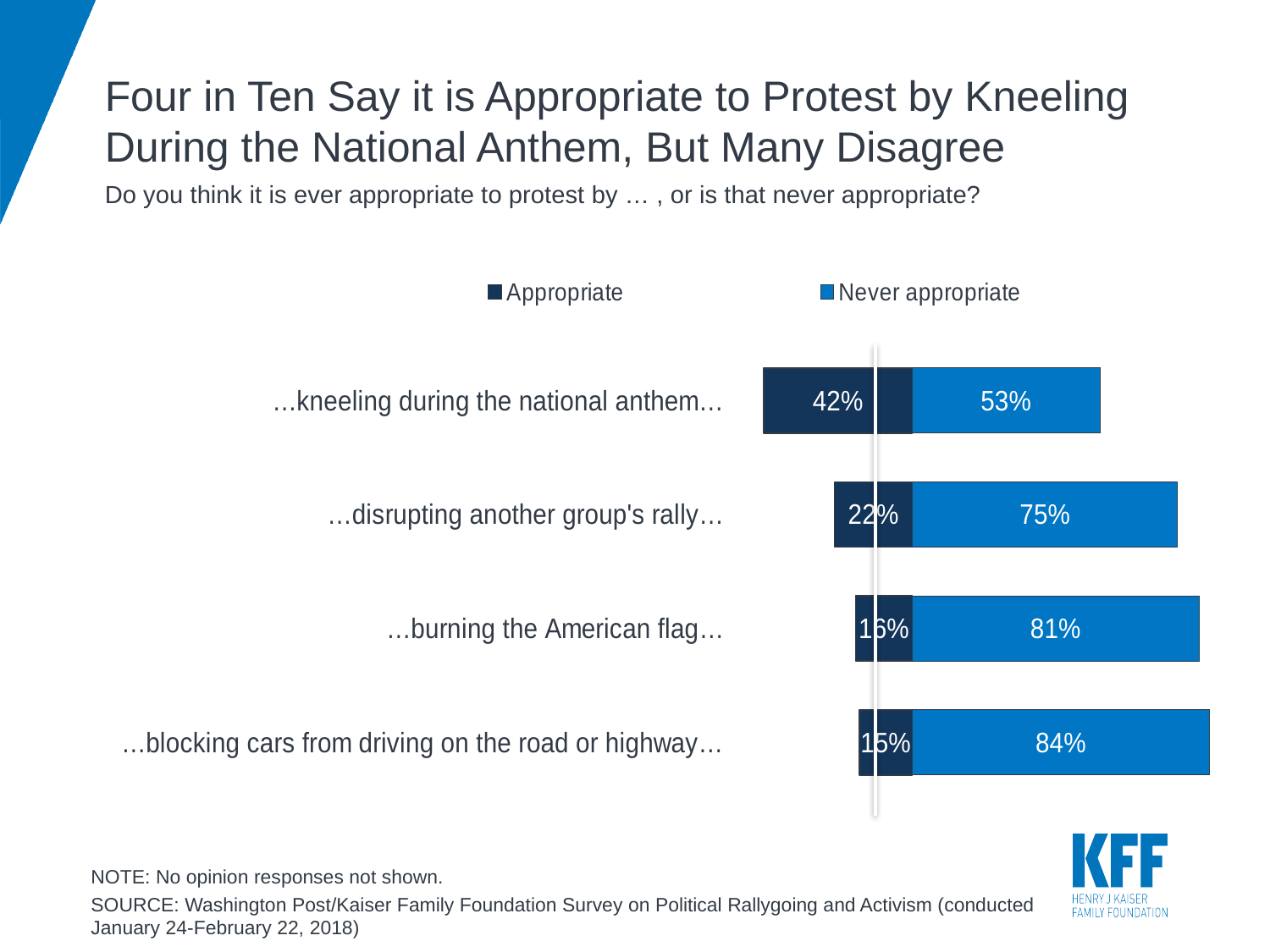
What is the difference between the share saying kneeling during the national anthem is never appropriate and the share saying it is appropriate? 11 percentage points Which protest action has the highest share saying it is never appropriate? …blocking cars from driving on the road or highway… Which protest action has the lowest share saying it is appropriate? …blocking cars from driving on the road or highway… How many protest actions are shown in the chart? 4 What kind of chart is shown on the slide? Bar chart Which is larger: the share saying disrupting another group's rally is appropriate, or the share saying burning the American flag is appropriate? Disrupting another group's rally What are the two legend entries in the chart? Appropriate; Never appropriate What percentage say it is never appropriate to protest by disrupting another group's rally? 75% How many series does the legend list? 2 What percentage say it is never appropriate to protest by burning the American flag? 81% What percentage say it is appropriate to protest by kneeling during the national anthem? 42% What percentage say it is appropriate to protest by blocking cars from driving on the road or highway? 15%